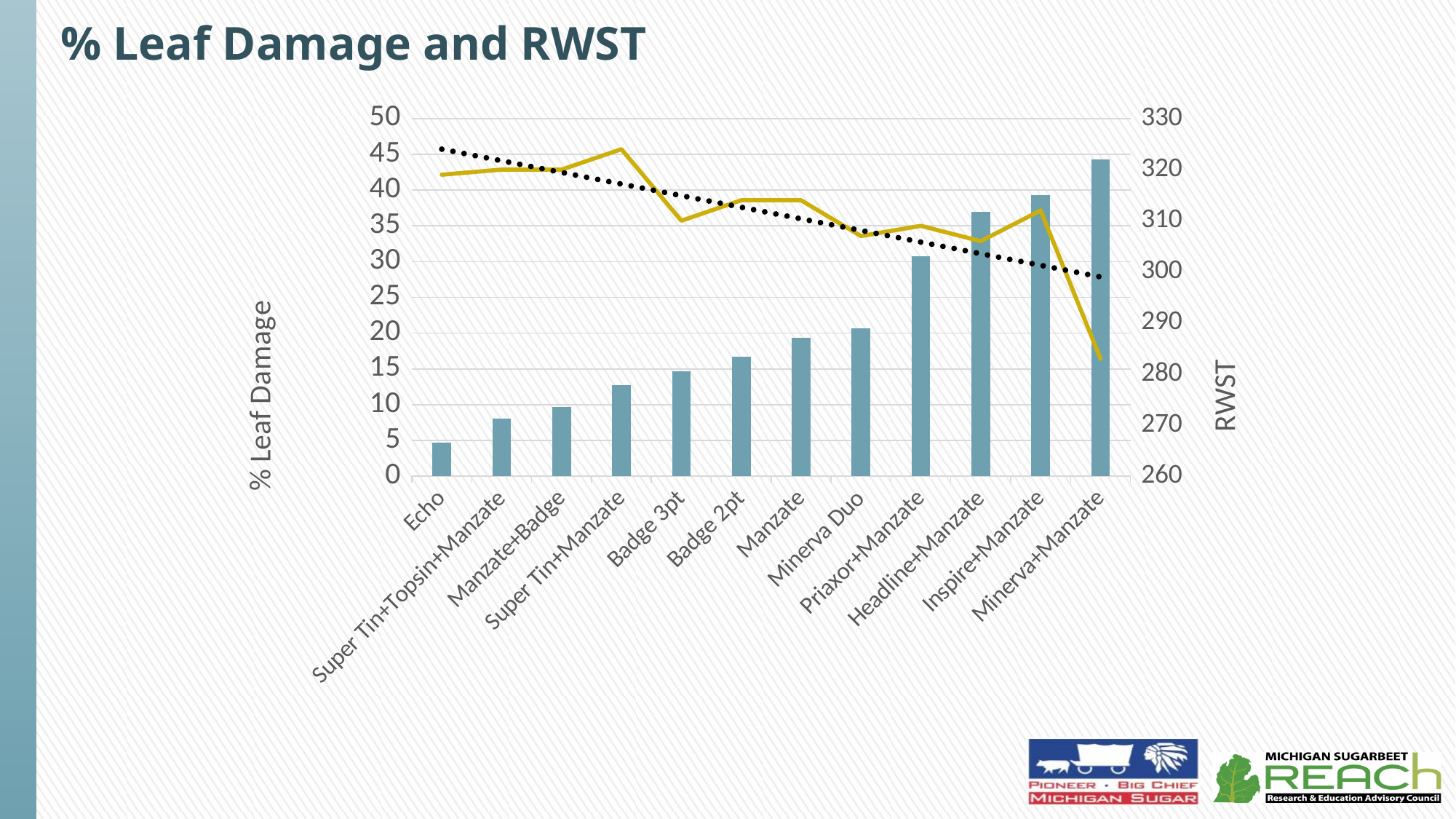
Do the % Leaf Damage bars rise or fall from left to right along the x axis? rise Is the % Leaf Damage value for Echo greater or less than 10? less What is the label of the right-hand vertical axis? RWST How many categories are shown on the x axis? 12 Is the % Leaf Damage value for Minerva+Manzate greater or less than 40? greater Is the RWST line value for Minerva+Manzate greater or less than 290? less What kind of chart is this? Combined bar and line chart Which category has the highest % Leaf Damage bar? Minerva+Manzate Which category has the lowest % Leaf Damage bar? Echo Which has a higher % Leaf Damage bar, Manzate or Headline+Manzate? Headline+Manzate